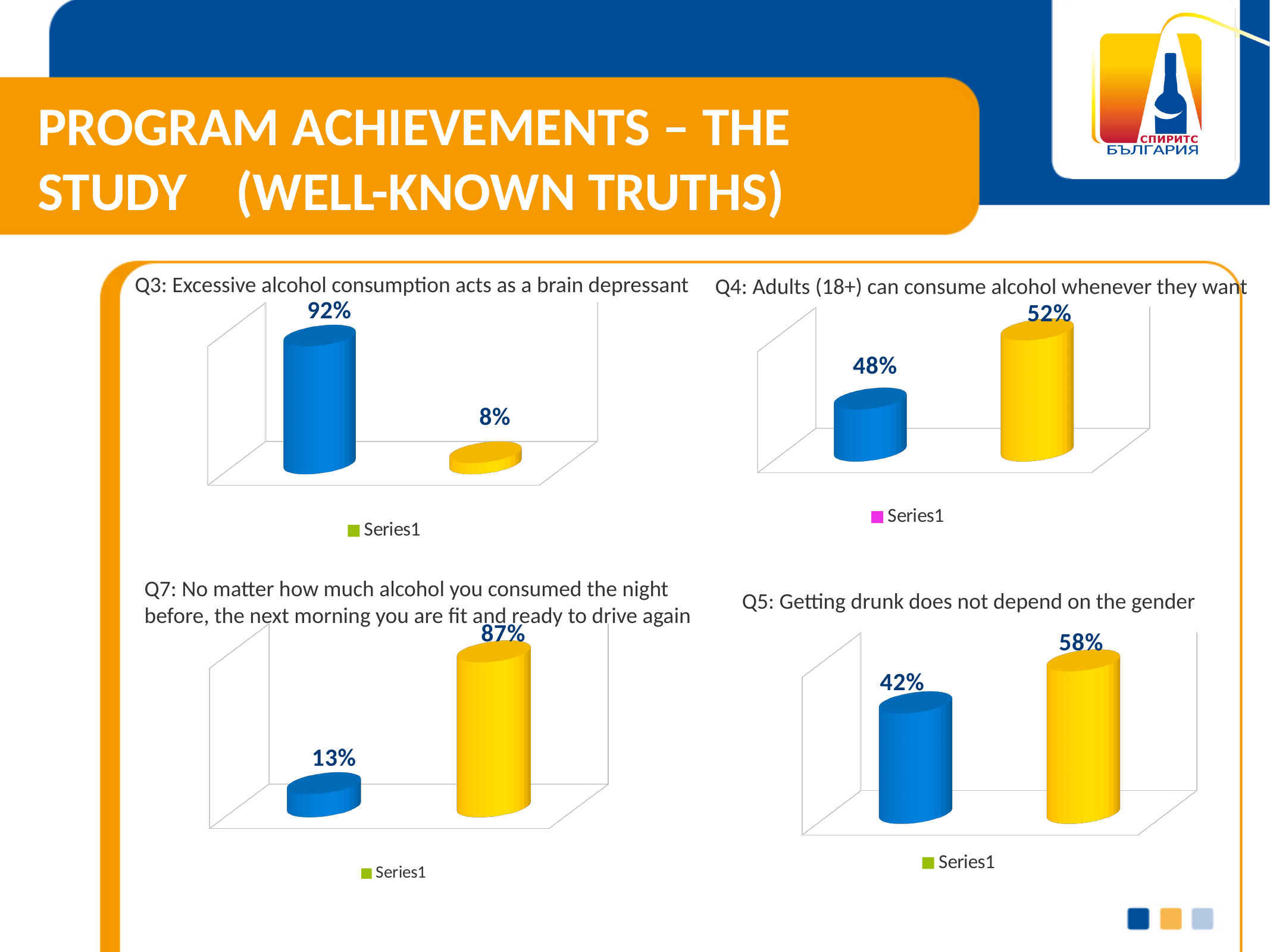
In the Q4 chart (Adults (18+) can consume alcohol whenever they want), what value is shown on the yellow bar? 52% What kind of chart is the Q3 chart (Excessive alcohol consumption acts as a brain depressant)? bar chart In the Q7 chart (No matter how much alcohol you consumed the night before...), what value is shown on the yellow bar? 87% In the Q3 chart (Excessive alcohol consumption acts as a brain depressant), what is the difference between the blue bar and the yellow bar? 84% In the Q3 chart (Excessive alcohol consumption acts as a brain depressant), what value is shown on the blue bar? 92% How many bars are plotted in the Q5 chart (Getting drunk does not depend on the gender)? 2 In the Q5 chart (Getting drunk does not depend on the gender), what is the difference between the yellow bar and the blue bar? 16% In the Q3 chart (Excessive alcohol consumption acts as a brain depressant), what value is shown on the yellow bar? 8% In the Q5 chart (Getting drunk does not depend on the gender), what value is shown on the blue bar? 42% In the Q7 chart (No matter how much alcohol you consumed the night before...), what value is shown on the blue bar? 13% In the Q4 chart (Adults (18+) can consume alcohol whenever they want), what value is shown on the blue bar? 48% In the Q4 chart (Adults (18+) can consume alcohol whenever they want), which bar is higher, the blue one or the yellow one? the yellow one